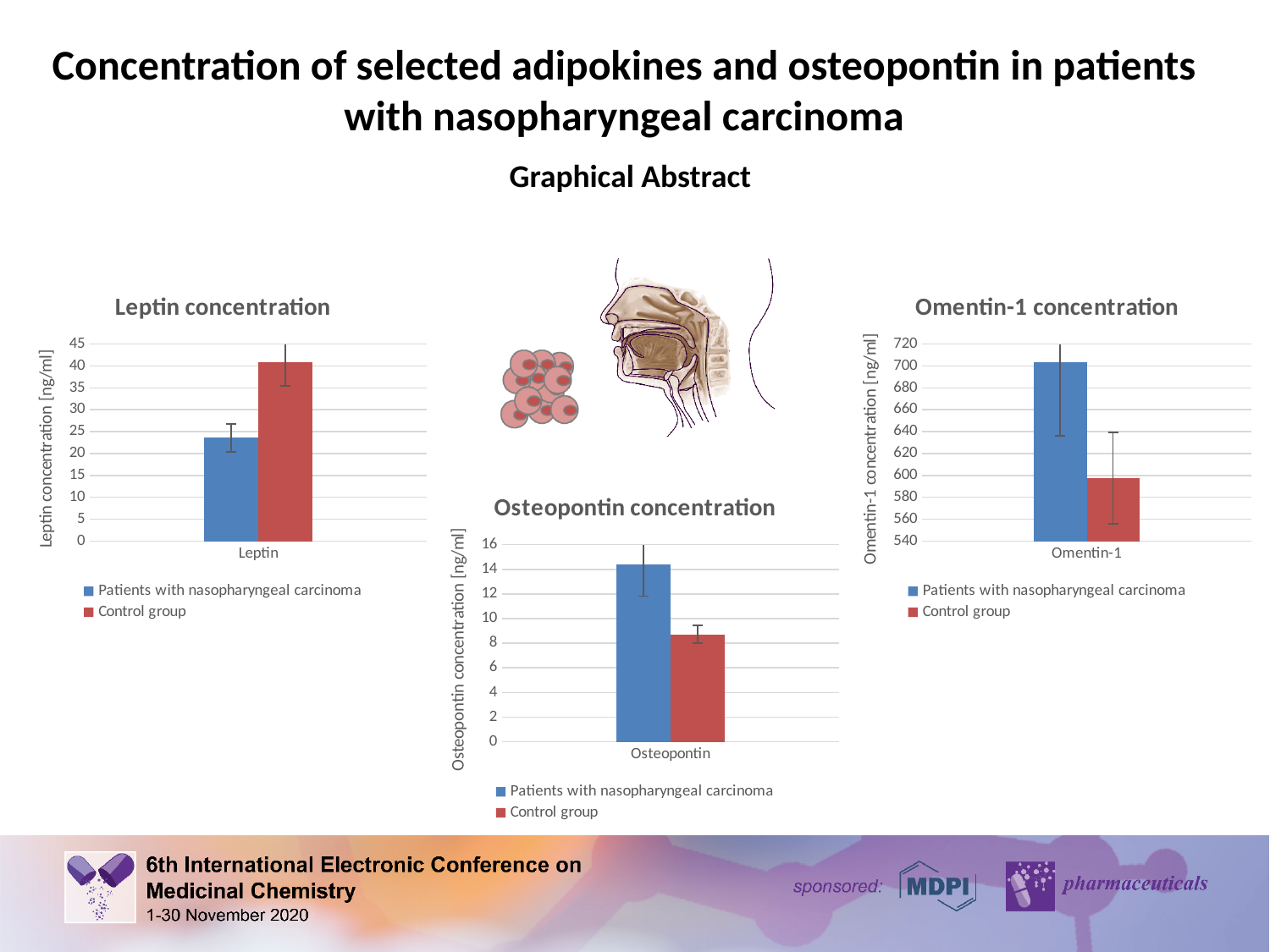
In the Omentin-1 concentration chart, which group has the higher omentin-1 concentration? Patients with nasopharyngeal carcinoma What type of chart is the Osteopontin concentration chart? Bar chart In the Leptin concentration chart, is the value for patients with nasopharyngeal carcinoma greater or less than 30? less How many series does the legend of the Omentin-1 concentration chart list? 2 What is the y-axis title of the Leptin concentration chart? Leptin concentration [ng/ml] In the Osteopontin concentration chart, which group has the higher osteopontin concentration? Patients with nasopharyngeal carcinoma In the Leptin concentration chart, which group has the higher leptin concentration, patients with nasopharyngeal carcinoma or the control group? Control group In the Osteopontin concentration chart, is the value for the control group greater or less than 10? less In the Omentin-1 concentration chart, is the value for patients with nasopharyngeal carcinoma greater or less than 680? greater